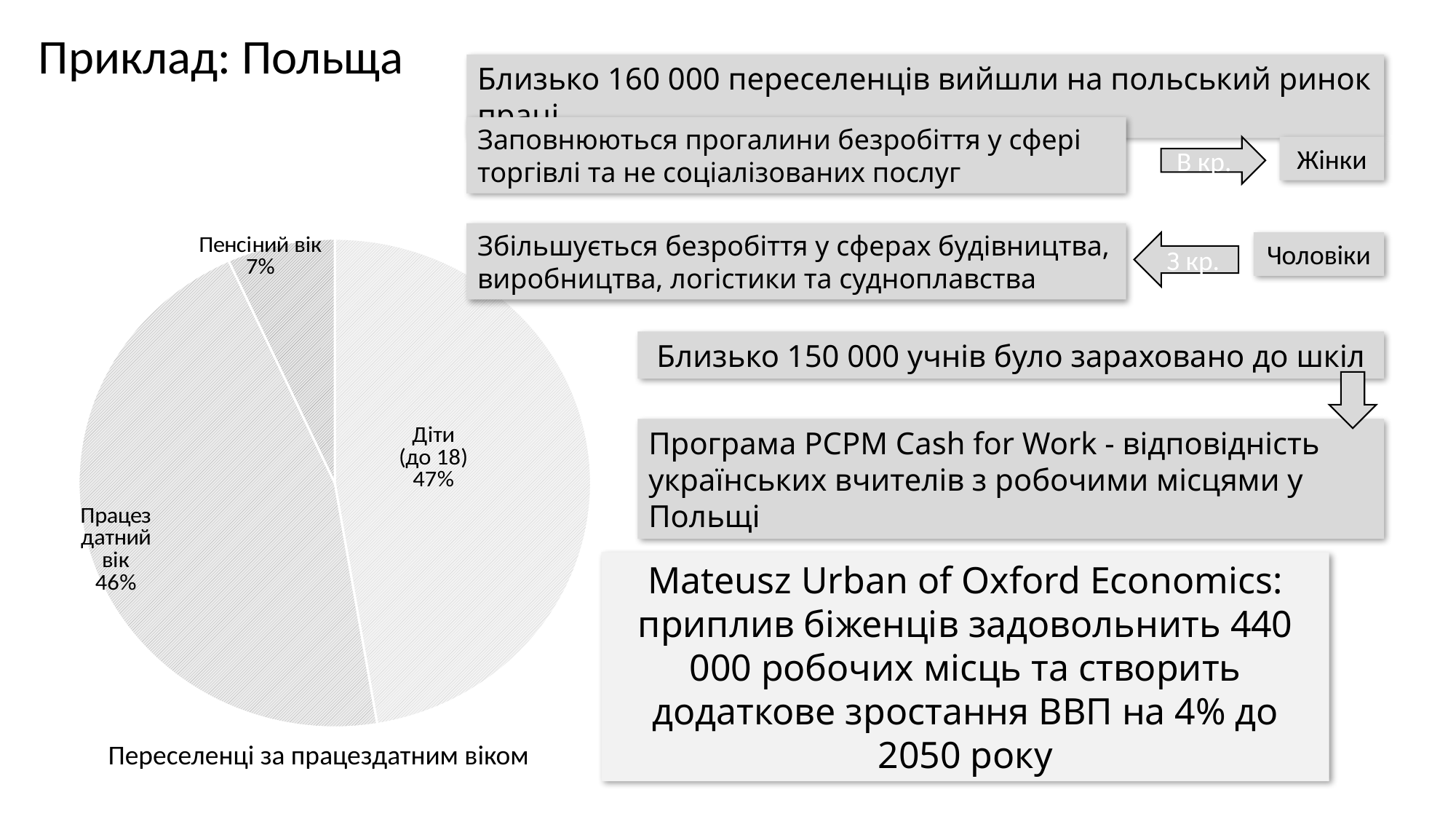
What share of the pie does the slice labelled "Працездатний вік" represent? 46% What is the caption written below the pie chart? Переселенці за працездатним віком What is the difference in percentage points between the "Працездатний вік" slice and the "Пенсійний вік" slice? 39 What share of the pie does the slice labelled "Діти (до 18)" represent? 47% What is the difference in percentage points between the "Діти (до 18)" slice and the "Пенсійний вік" slice? 40 What share of the pie does the slice labelled "Пенсійний вік" represent? 7% How many slices does the pie chart have? 3 Which category has the smallest slice in the pie chart? Пенсіний вік Which slice is larger: "Діти (до 18)" or "Працездатний вік"? Діти (до 18) Which category has the largest slice in the pie chart? Діти (до 18) Which slice is larger: "Працездатний вік" or "Пенсійний вік"? Працездатний вік What kind of chart is shown on the slide? Pie chart